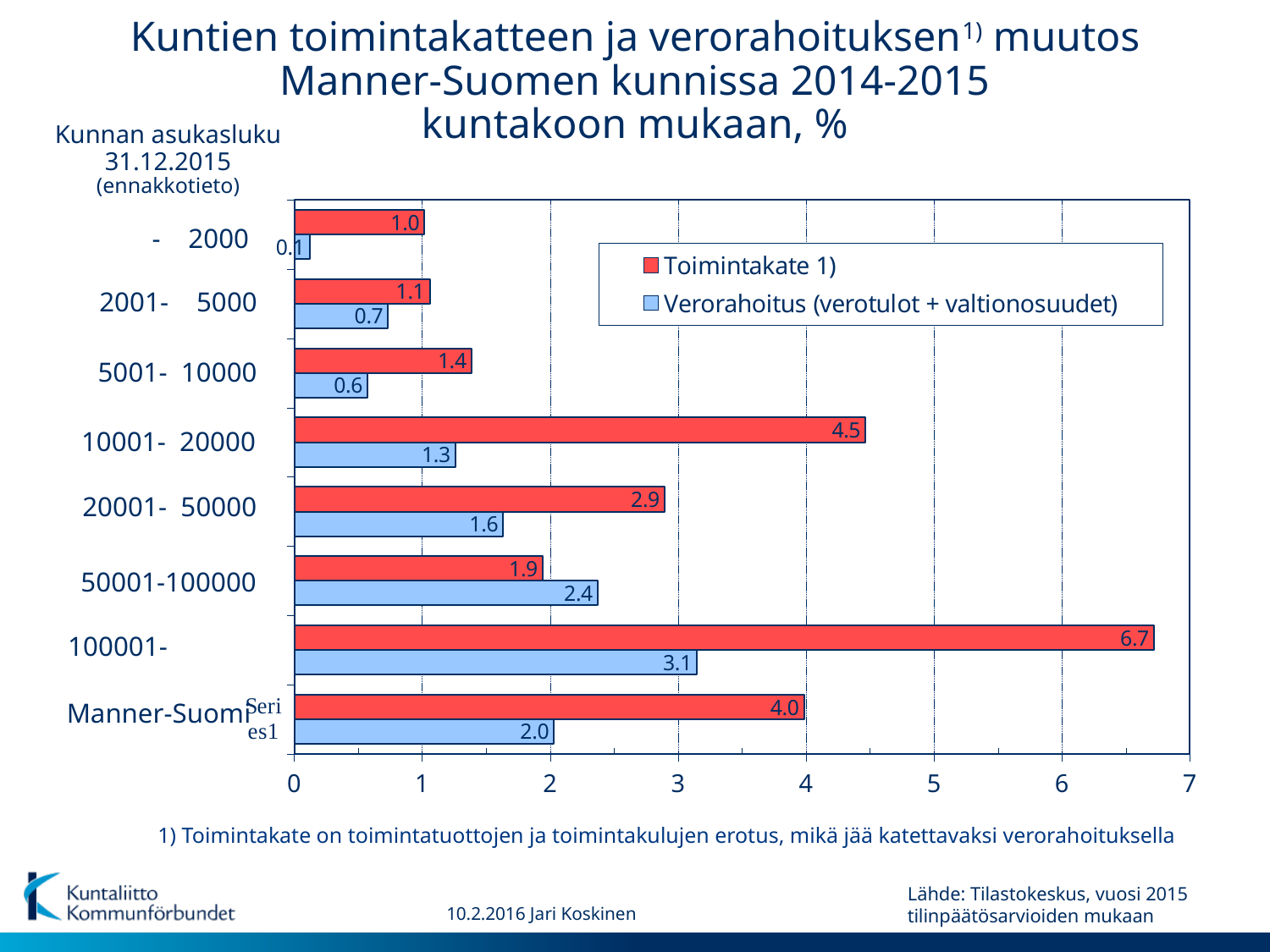
Is the Toimintakate value for the 20001- 50000 category greater or less than 2? greater What is the Verorahoitus value for the 50001-100000 category? 2.4 How many series does the legend list? 2 What is the difference between the Toimintakate and Verorahoitus values for the 10001- 20000 category? 3.2 What is the Verorahoitus value for Manner-Suomi? 2.0 What type of chart is shown on the slide? Bar chart How many categories are shown on the vertical axis of the chart? 8 Which category has the lowest Verorahoitus value? - 2000 What colour are the Toimintakate bars? Red For the 50001-100000 category, which is larger: Toimintakate or Verorahoitus? Verorahoitus Which category has the highest Toimintakate value? 100001- What is the Toimintakate value for the 100001- category? 6.7